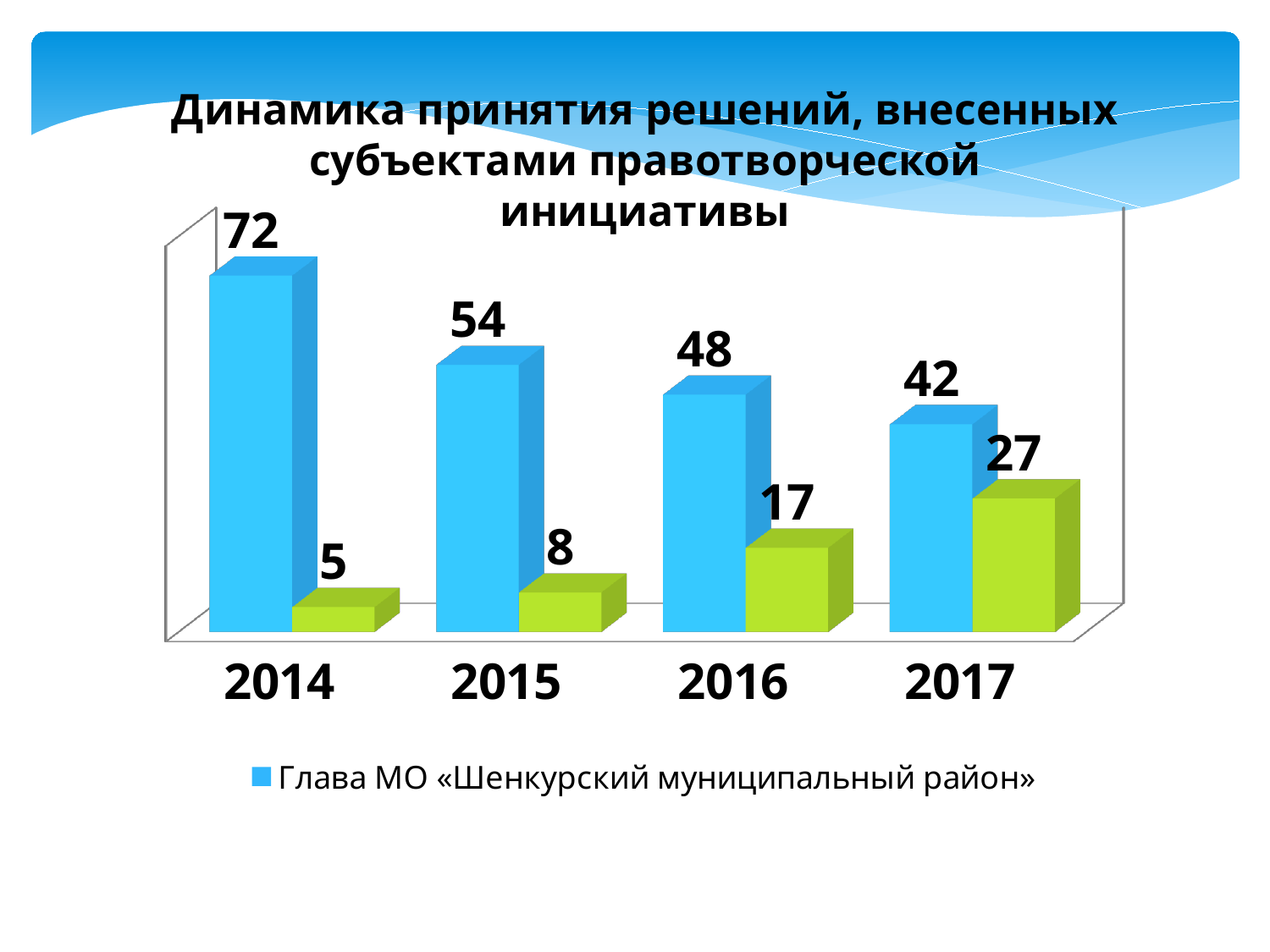
What kind of chart is shown on the slide? bar chart Does the value for Глава МО «Шенкурский муниципальный район» rise or fall from 2014 to 2017? fall What is the value of the green series in 2015? 8 In which year is the value for Глава МО «Шенкурский муниципальный район» highest? 2014 In which year is the green series lowest? 2014 What is the value for Глава МО «Шенкурский муниципальный район» in 2014? 72 Which is larger in 2016: the blue series value or the green series value? the blue series (48) What is the value of the green series in 2016? 17 By how much did the value for Глава МО «Шенкурский муниципальный район» fall from 2014 to 2015? 18 How many years are shown on the x axis? 4 What is the difference between the blue and green values in 2017? 15 What is the value of the blue series (Глава МО «Шенкурский муниципальный район») in 2017? 42